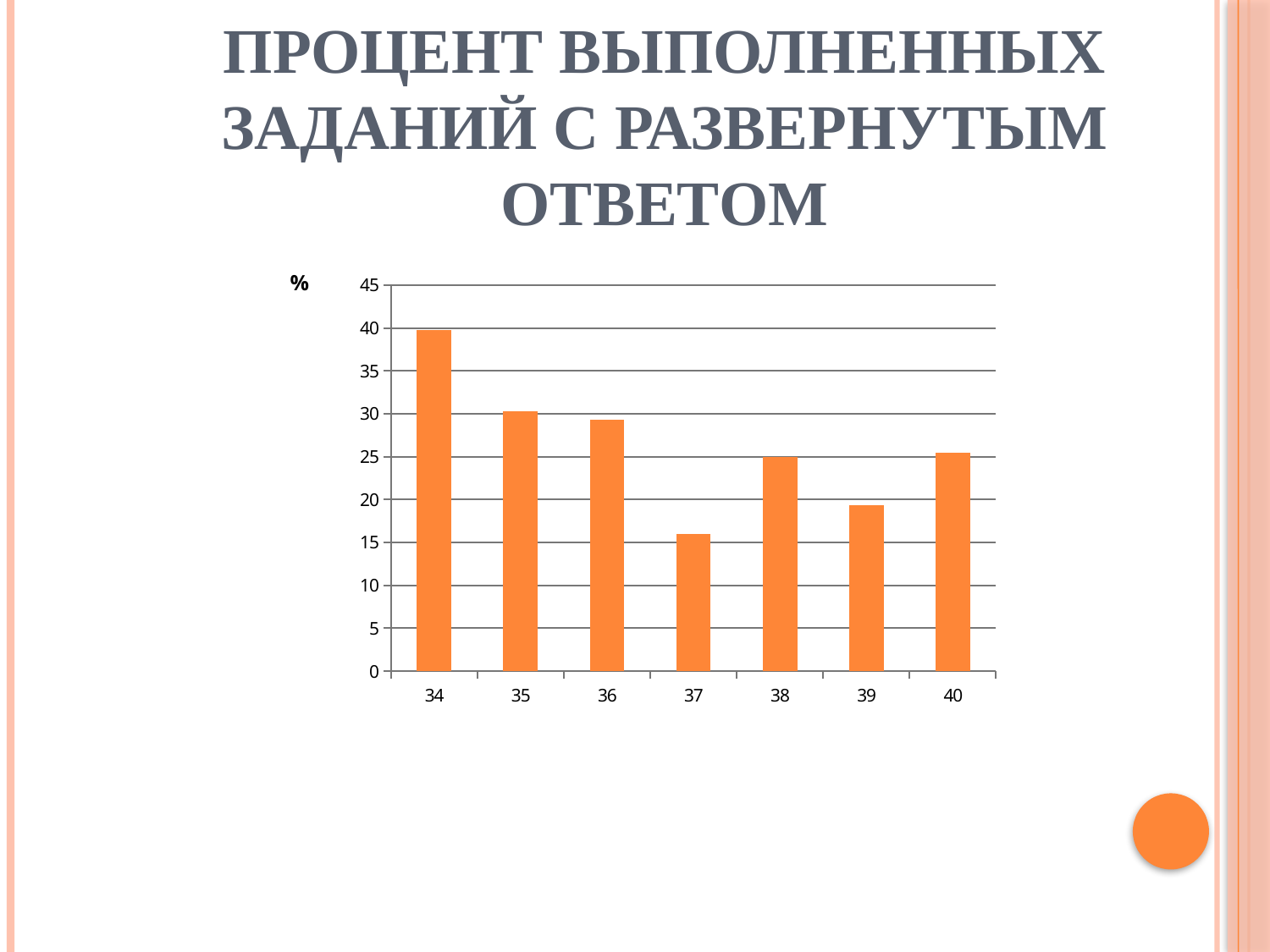
Which has the larger value, category 34 or category 37? 34 What kind of chart is shown on the slide? bar chart Is the value for category 37 greater or less than 20? less Is the value for category 35 greater or less than 25? greater Which category has the highest bar in the chart? 34 Is the value for category 40 greater or less than 20? greater Do the values rise or fall from category 34 to category 37? fall Which category has the lowest bar in the chart? 37 What unit label is shown next to the vertical axis of the chart? % How many categories are shown on the x axis of the chart? 7 Which has the larger value, category 36 or category 40? 36